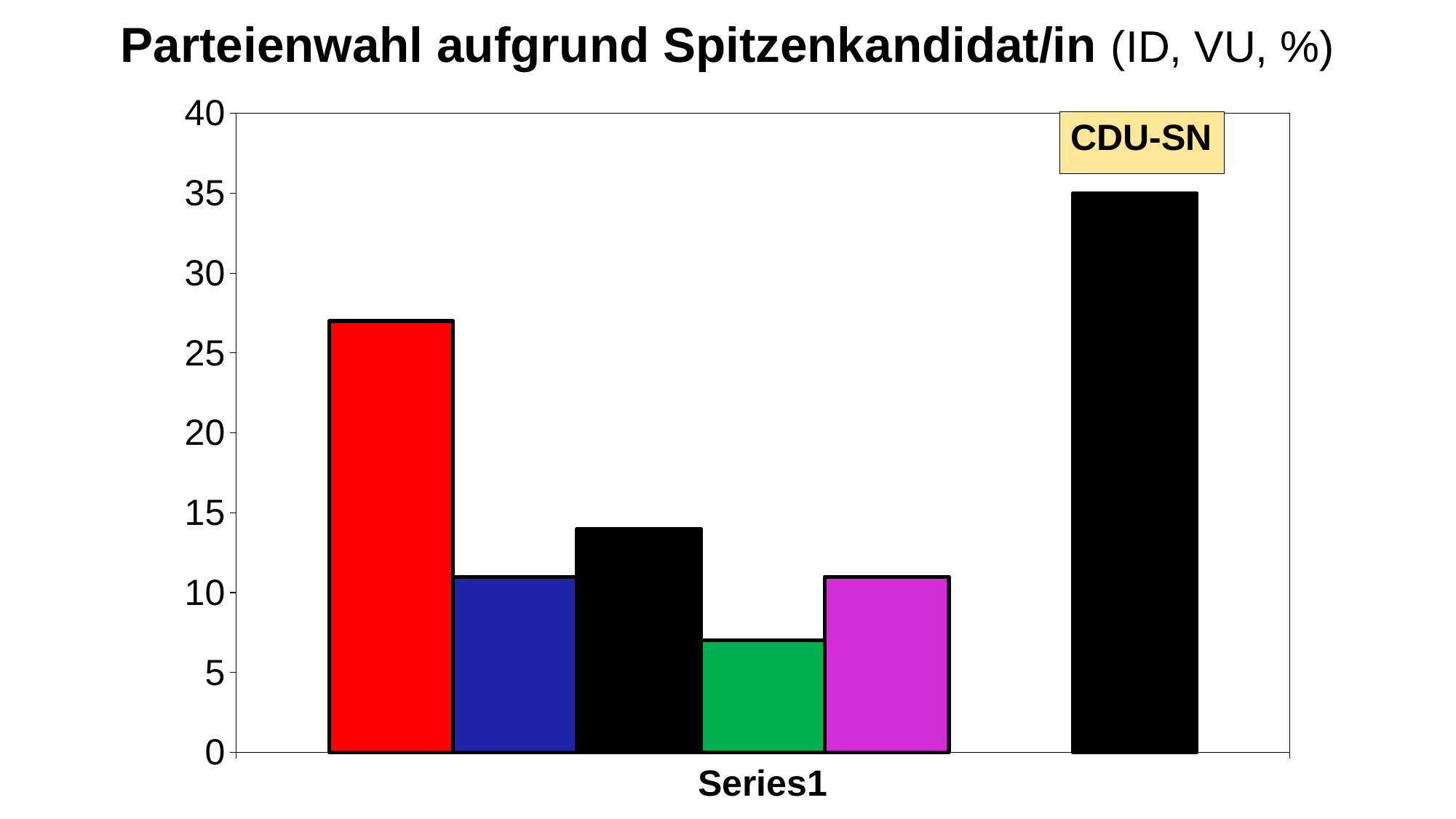
Which bar is the highest in the chart? CDU-SN What kind of chart is shown on the slide? bar chart What value does the bar labelled CDU-SN reach? 35 Which is larger, the red bar or the black bar in the left group? the red bar Is the value of the black bar in the left group greater or less than 15? less Is the value of the green bar greater or less than 10? less Which coloured bar is the lowest in the chart? the green bar What is the title of the chart? Parteienwahl aufgrund Spitzenkandidat/in (ID, VU, %) How many bars are plotted in the chart? 6 Is the value of the magenta bar greater or less than 10? greater What label is shown on the x axis below the left group of bars? Series1